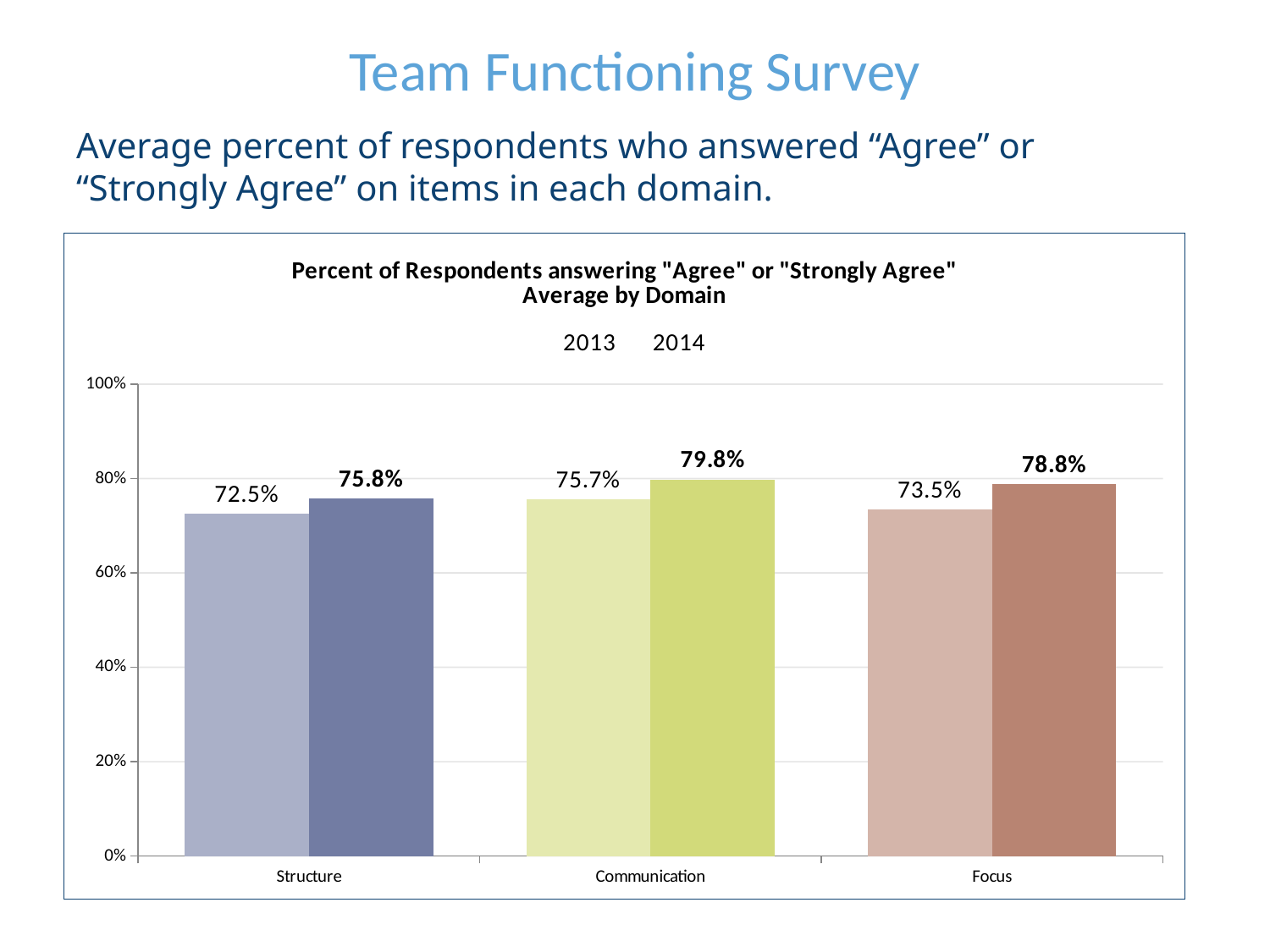
Which domain has the lowest 2013 value? Structure How many series does the legend list? 2 How many domains are shown on the x axis? 3 Which is larger, the 2013 value for Communication or the 2014 value for Structure? 2014 value for Structure What is the 2013 value for Focus? 73.5% What kind of chart is shown? Bar chart Which domain has the highest 2014 value? Communication What is the 2014 value for Communication? 79.8% What is the 2013 value for Structure? 72.5% What is the difference between the 2014 and 2013 values for Structure? 3.3% What is the 2014 value for Structure? 75.8% What is the difference between the 2014 and 2013 values for Focus? 5.3%